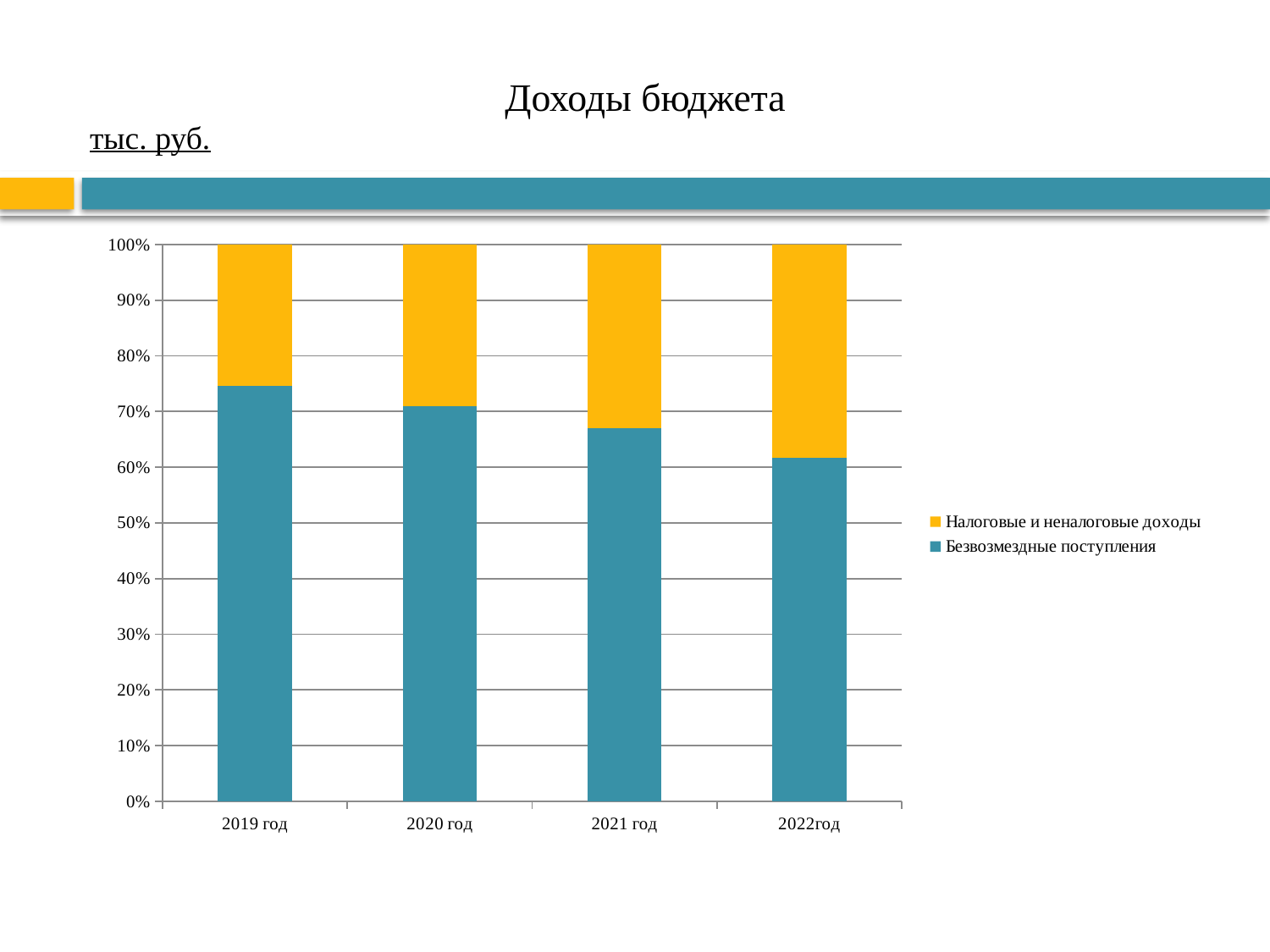
Which series is shown in yellow in the chart? Налоговые и неналоговые доходы Does the share of Безвозмездные поступления rise or fall from 2019 год to 2022год? fall How many series does the chart legend list? 2 Is the share of Безвозмездные поступления in 2022год greater or less than 70%? less What is the title of the slide containing the chart? Доходы бюджета What kind of chart is shown on the slide? stacked bar chart In which year is the share of Безвозмездные поступления lowest? 2022год Which is larger: the share of Налоговые и неналоговые доходы in 2019 год or in 2022год? 2022год In which year is the share of Налоговые и неналоговые доходы highest? 2022год How many years (categories) are shown on the x axis of the chart? 4 Is the share of Безвозмездные поступления in 2019 год greater or less than 70%? greater In which year is the share of Безвозмездные поступления highest? 2019 год